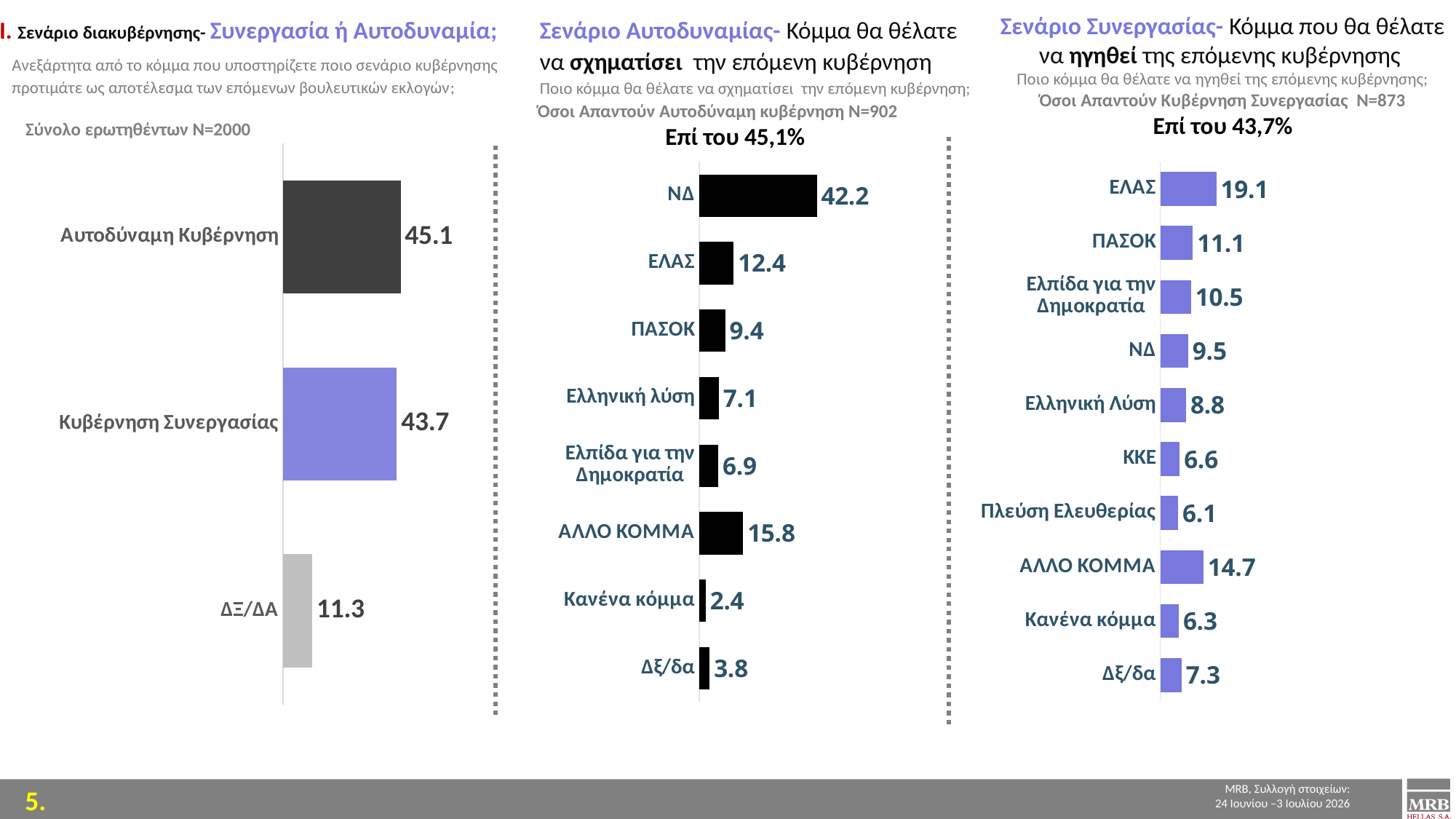
In the left chart (Σενάριο διακυβέρνησης), what is the difference between Αυτοδύναμη Κυβέρνηση and Κυβέρνηση Συνεργασίας? 1.4 In the middle chart (Σενάριο Αυτοδυναμίας), which category has the lowest value? Κανένα κόμμα In the right chart (Σενάριο Συνεργασίας), which category has the highest value? ΕΛΑΣ In the right chart (Σενάριο Συνεργασίας), how many categories are shown? 10 In the right chart (Σενάριο Συνεργασίας), what is the value for ΕΛΑΣ? 19.1 In the middle chart (Σενάριο Αυτοδυναμίας), how many categories are shown? 8 What kind of chart is the left chart (Σενάριο διακυβέρνησης)? Bar chart In the left chart (Σενάριο διακυβέρνησης), what is the value for Αυτοδύναμη Κυβέρνηση? 45.1 In the middle chart (Σενάριο Αυτοδυναμίας), which is larger, ΕΛΑΣ or ΑΛΛΟ ΚΟΜΜΑ? ΑΛΛΟ ΚΟΜΜΑ In the left chart (Σενάριο διακυβέρνησης), which category has the lowest value? ΔΞ/ΔΑ In the middle chart (Σενάριο Αυτοδυναμίας), what is the value for ΝΔ? 42.2 In the right chart (Σενάριο Συνεργασίας), what is the difference between ΠΑΣΟΚ and ΝΔ? 1.6